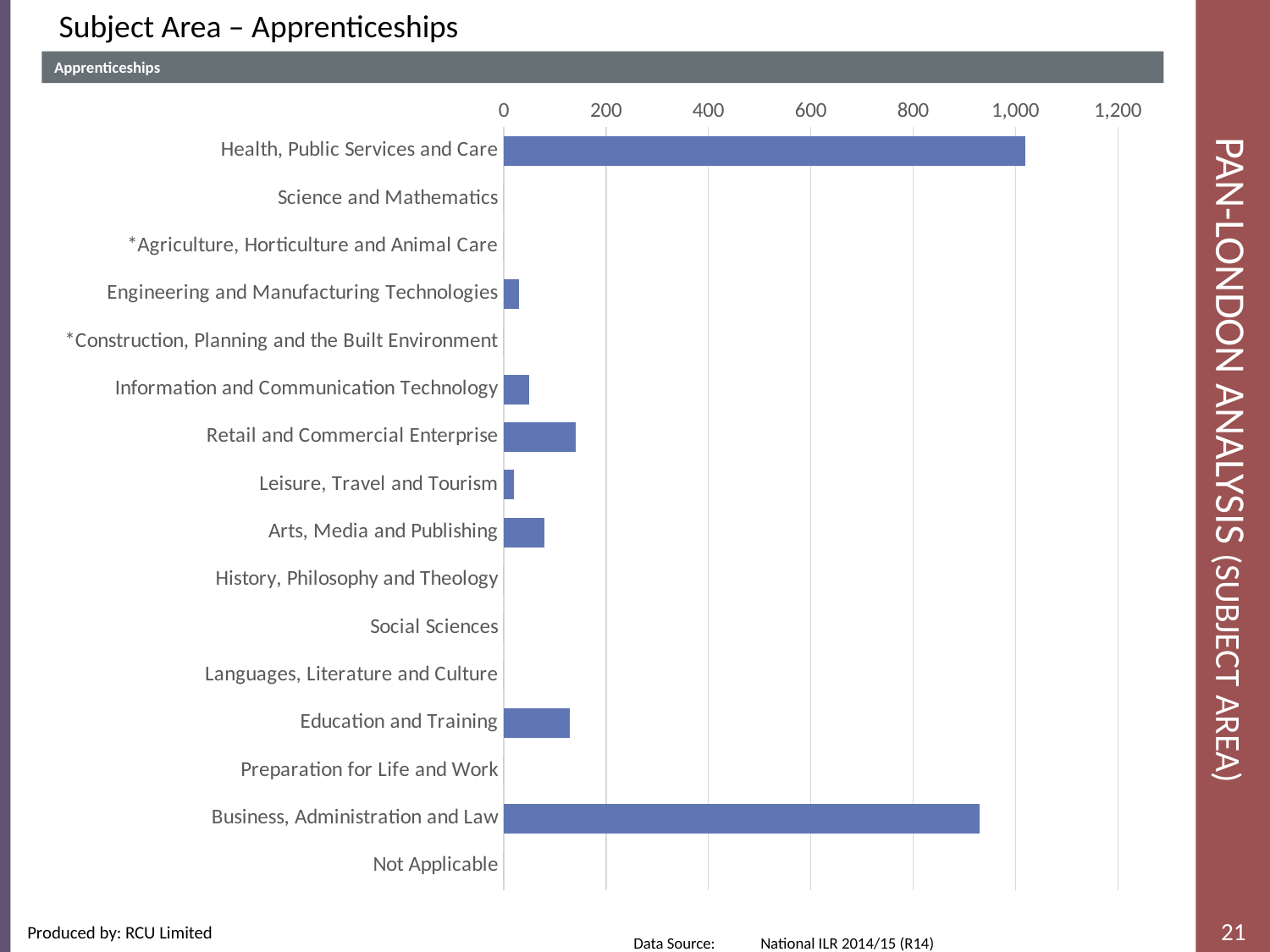
Is the value for Health, Public Services and Care greater or less than 1,000? greater What is the title of the slide? Subject Area – Apprenticeships Which has the larger value: Health, Public Services and Care or Business, Administration and Law? Health, Public Services and Care What kind of chart is shown on the slide? bar chart Is the value for Business, Administration and Law greater or less than 800? greater Is the value for Business, Administration and Law greater or less than 1,000? less Which has the larger value: Retail and Commercial Enterprise or Arts, Media and Publishing? Retail and Commercial Enterprise What is the highest value shown on the horizontal axis? 1,200 Which subject area has the highest number of apprenticeships? Health, Public Services and Care How many subject area categories are listed on the chart? 16 Which has the larger value: Information and Communication Technology or Education and Training? Education and Training